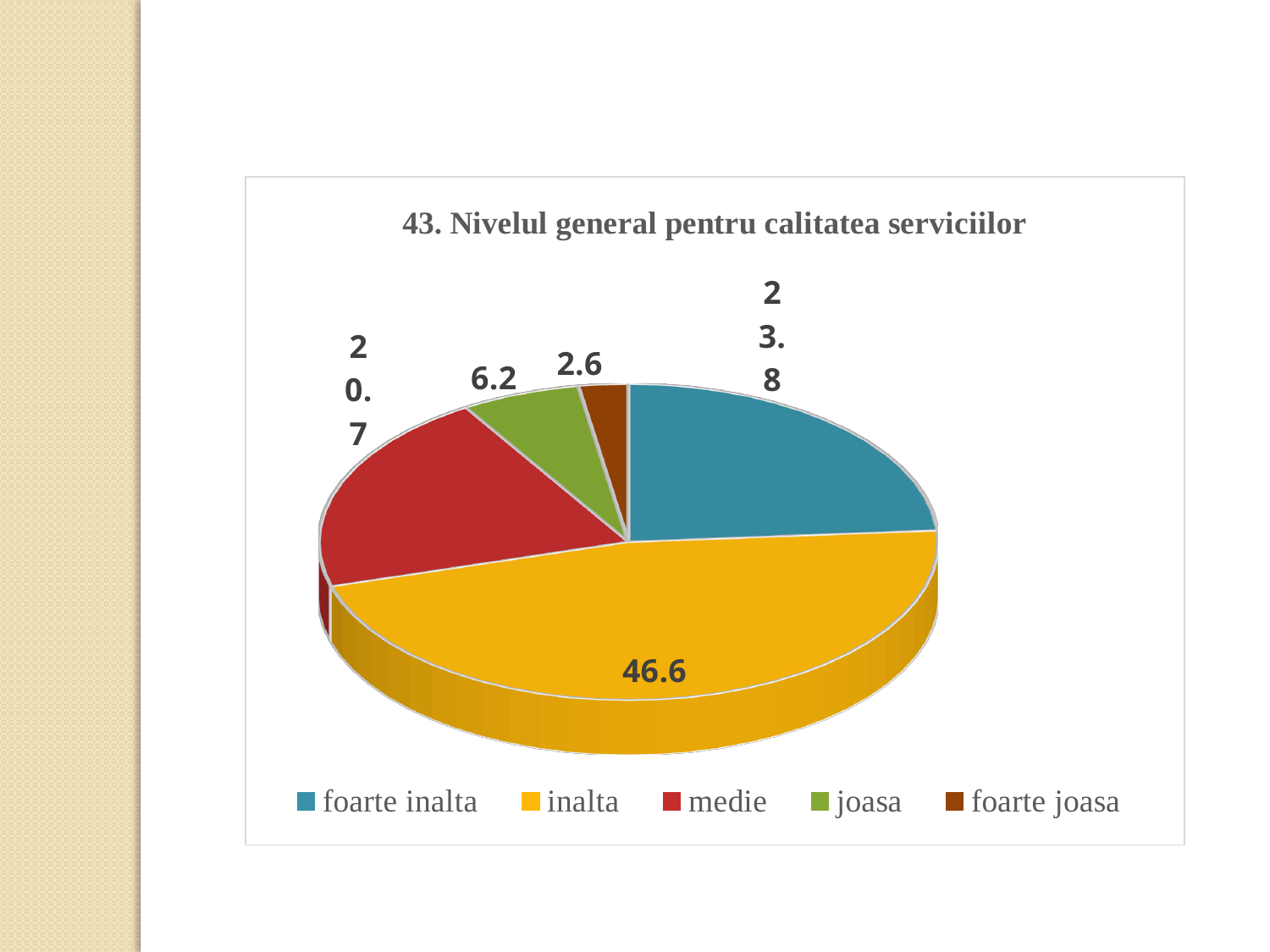
What is the value for the 'foarte joasa' slice? 2.6 What is the value for the 'medie' slice? 20.7 Which category has the largest slice? inalta What is the difference between the values for 'inalta' and 'foarte inalta'? 22.8 What is the value for the 'joasa' slice? 6.2 What is the value for the 'foarte inalta' slice? 23.8 What type of chart is shown on the slide? pie chart What is the value for the 'inalta' slice? 46.6 Which category has the smallest slice? foarte joasa How many categories does the legend list? 5 Which is larger, the value for 'foarte inalta' or the value for 'medie'? foarte inalta What is the title of the chart? 43. Nivelul general pentru calitatea serviciilor